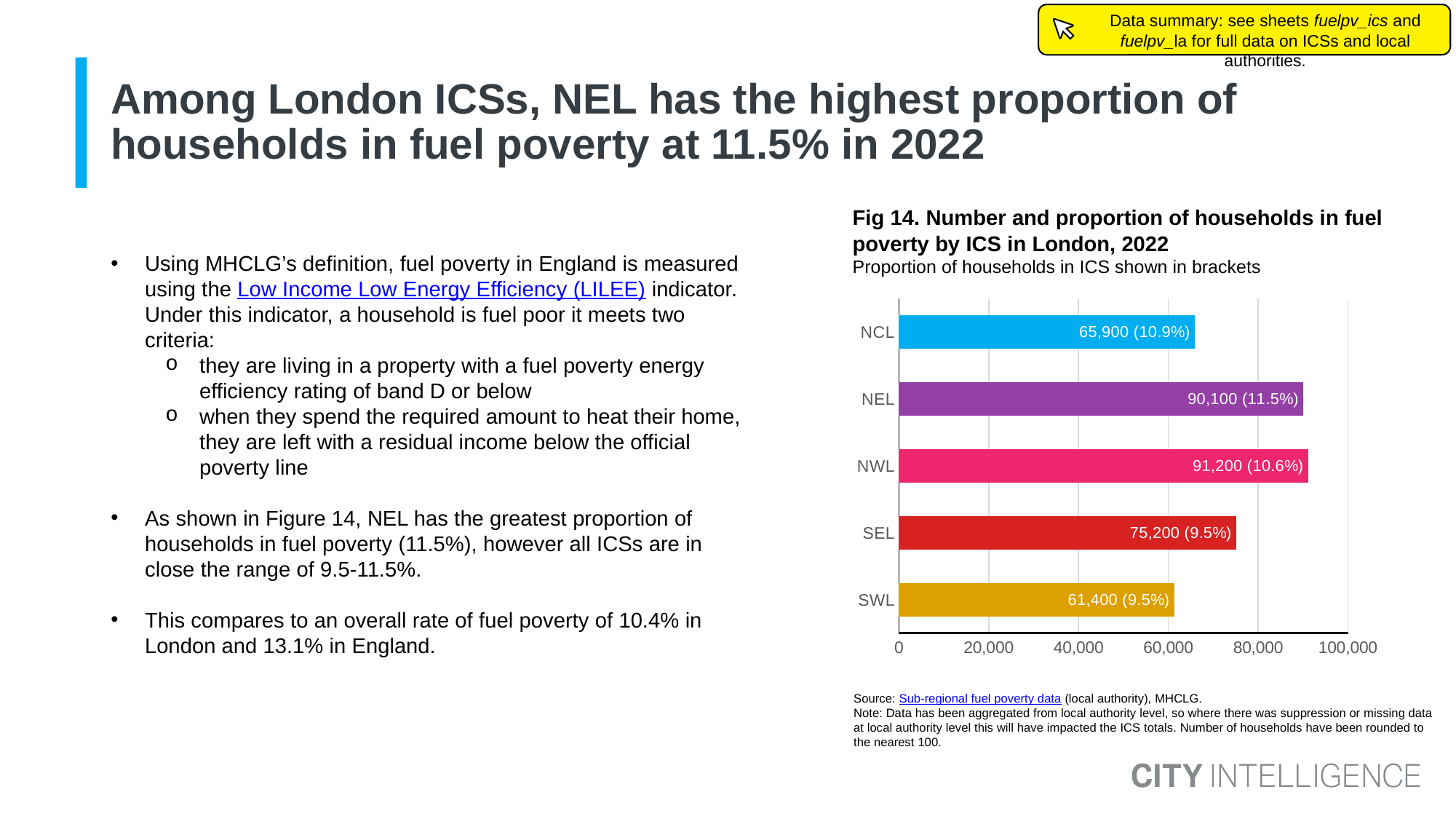
What is the difference in the number of households in fuel poverty between SEL and SWL? 13,800 What proportion of households in SEL are in fuel poverty, as shown in brackets? 9.5% How many ICSs are shown in the chart? 5 Which ICS has the lowest number of households in fuel poverty? SWL Which has more households in fuel poverty, NCL or SEL? SEL What colour is the bar for NEL? purple Is the value for NCL greater or less than 60,000? greater Which ICS has the highest number of households in fuel poverty? NWL What is the data label shown for SWL? 61,400 (9.5%) What type of chart is Fig 14? bar chart What is the difference in the number of households in fuel poverty between NWL and NEL? 1,100 What is the number of households in fuel poverty for NEL? 90,100